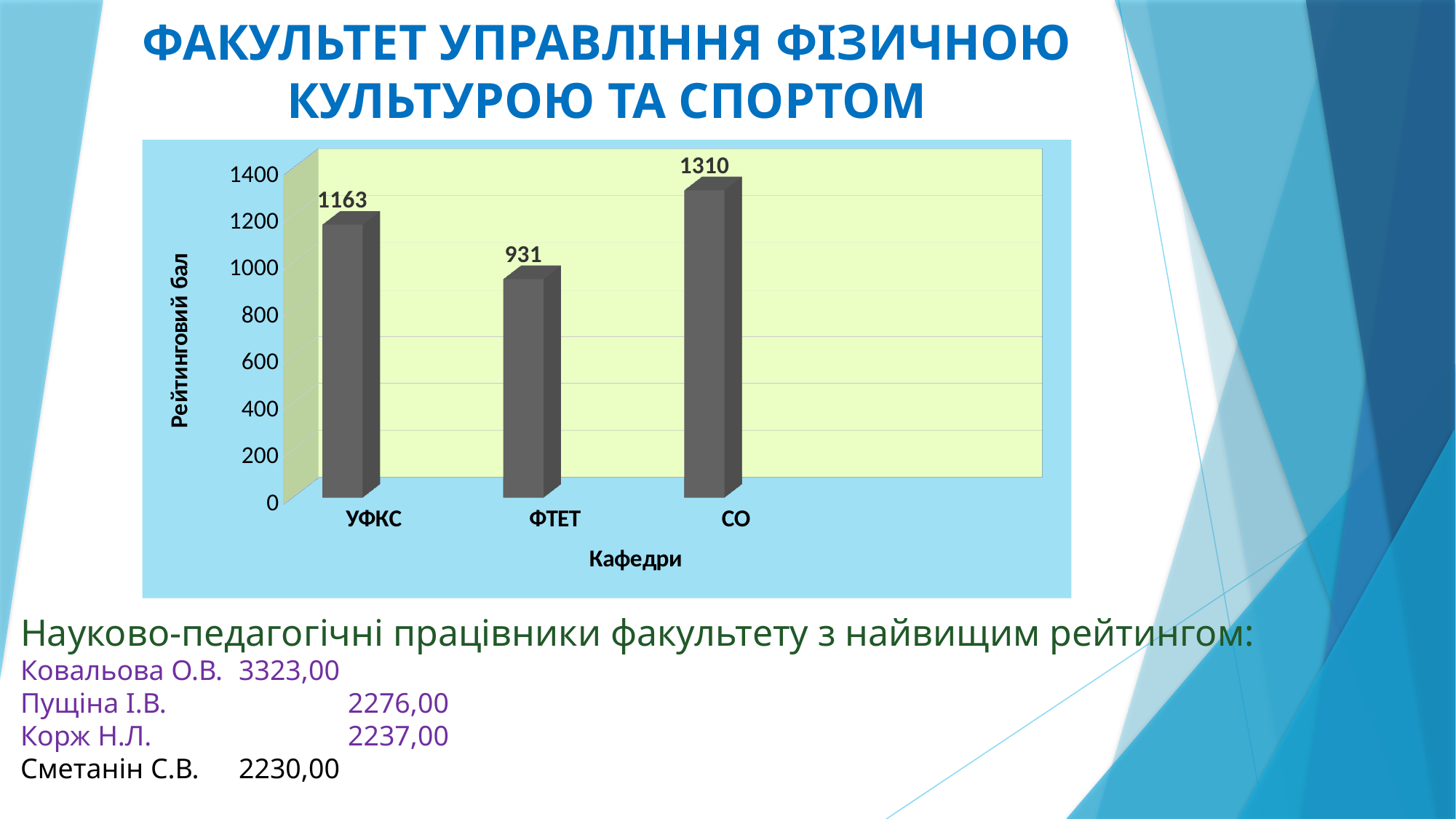
Which department (кафедра) has the highest rating score? СО Which department has the lowest rating score? ФТЕТ What kind of chart is shown on the slide? bar chart What is the label of the vertical axis of the chart? Рейтинговий бал How many departments are shown on the chart? 3 What is the difference between the rating scores of СО and УФКС? 147 What is the rating score for ФТЕТ? 931 What is the rating score for СО? 1310 What is the rating score (Рейтинговий бал) for УФКС? 1163 What is the difference between the rating scores of УФКС and ФТЕТ? 232 Is the value for ФТЕТ greater or less than 1000? less Which has a higher rating score, УФКС or ФТЕТ? УФКС